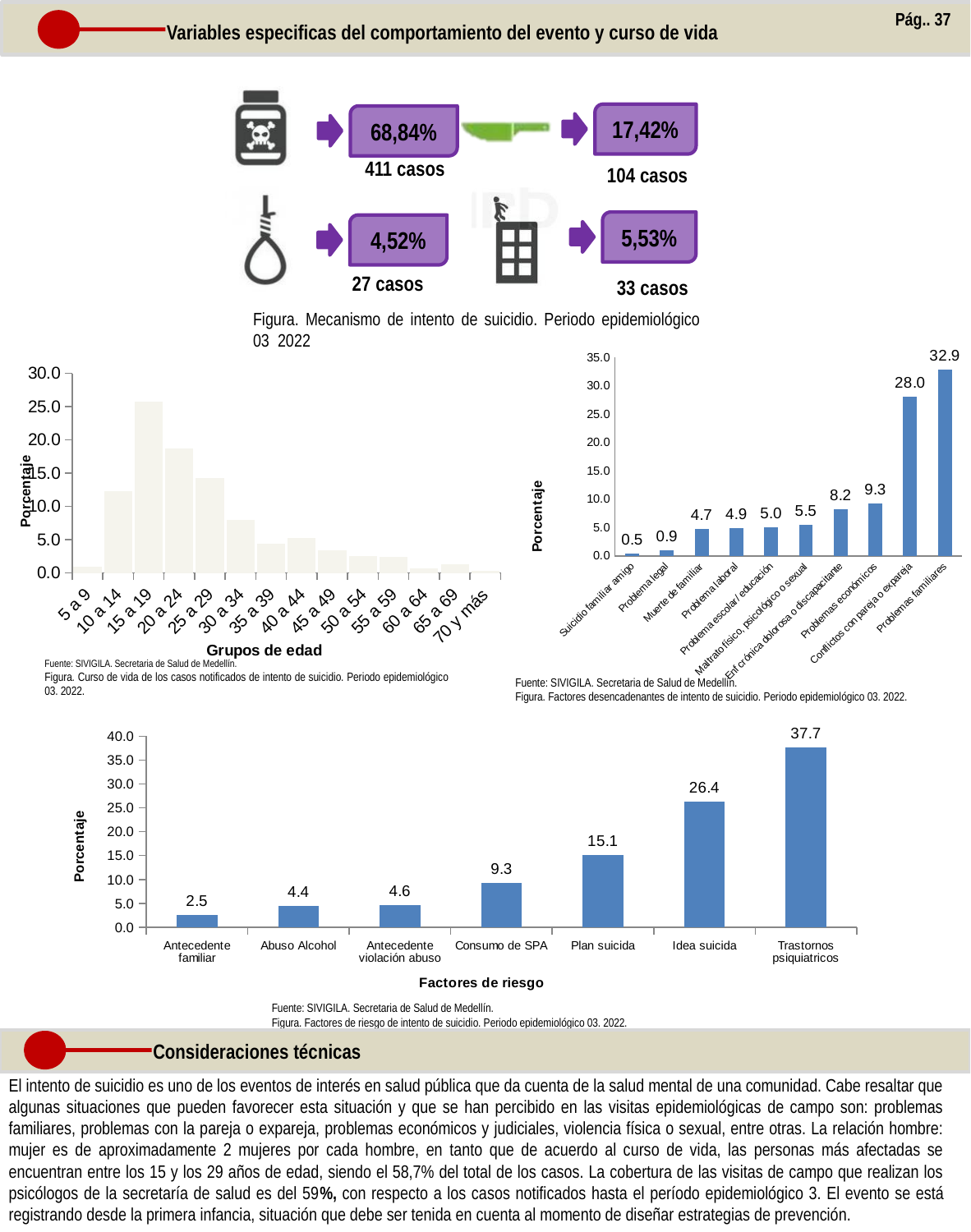
In the chart titled 'Curso de vida de los casos notificados de intento de suicidio', how many age groups are shown on the x axis? 14 In the chart titled 'Factores de riesgo de intento de suicidio', which risk factor has the lowest value? Antecedente familiar In the chart titled 'Curso de vida de los casos notificados de intento de suicidio', is the value for the 15 a 19 age group greater or less than 25.0? greater In the chart titled 'Factores desencadenantes de intento de suicidio', what is the value for Problemas económicos? 9.3 In the chart titled 'Factores de riesgo de intento de suicidio', how many risk factors are shown on the x axis? 7 In the chart titled 'Factores de riesgo de intento de suicidio', what is the value for Consumo de SPA? 9.3 In the chart titled 'Factores desencadenantes de intento de suicidio', which is larger: Maltrato físico, psicológico o sexual or Problema laboral? Maltrato físico, psicológico o sexual In the chart titled 'Factores desencadenantes de intento de suicidio', what is the difference between Problemas familiares and Conflictos con pareja o expareja? 4.9 In the chart titled 'Curso de vida de los casos notificados de intento de suicidio', which age group has the highest percentage? 15 a 19 In the chart titled 'Factores de riesgo de intento de suicidio', what is the difference between Trastornos psiquiatricos and Idea suicida? 11.3 In the chart titled 'Factores de riesgo de intento de suicidio', what is the value for Trastornos psiquiatricos? 37.7 In the chart titled 'Factores desencadenantes de intento de suicidio', which category has the highest value? Problemas familiares